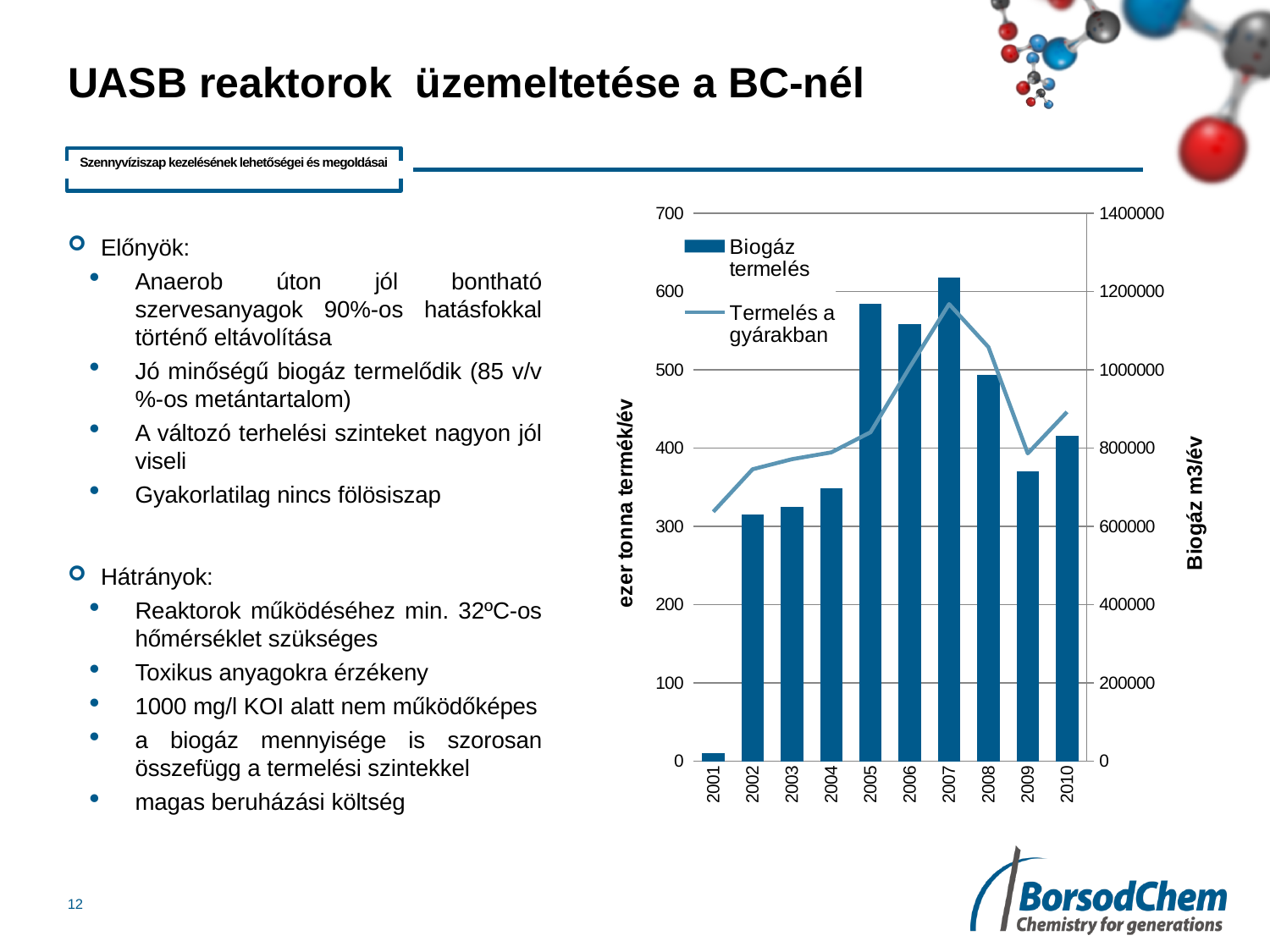
In which year is the Biogáz termelés bar the highest? 2007 What is the title of the right-hand vertical axis of the chart? Biogáz m3/év In which year does the Termelés a gyárakban line reach its peak? 2007 In which year is the Biogáz termelés bar the lowest? 2001 Is the Biogáz termelés bar higher in 2009 or in 2010? 2010 Is the Biogáz termelés bar higher in 2008 or in 2009? 2008 How many years are shown on the x axis of the chart? 10 Is the Termelés a gyárakban value for 2007 greater or less than 500 on the left axis? greater How many series does the chart legend list? 2 Does the Termelés a gyárakban line rise or fall from 2001 to 2007? rise Do the Biogáz termelés bars rise or fall from 2007 to 2009? fall Is the Termelés a gyárakban value for 2010 greater or less than 500 on the left axis? less